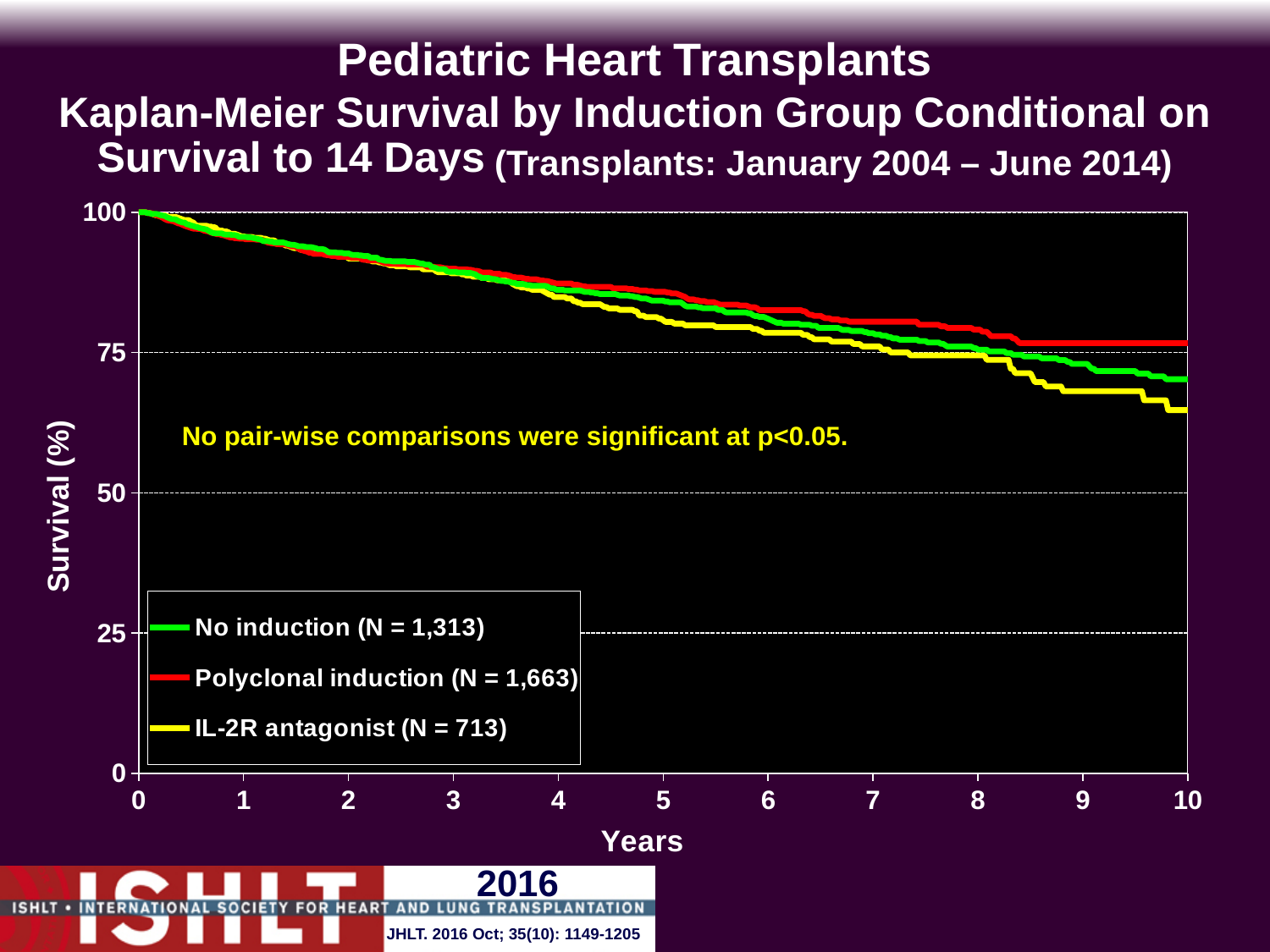
Is the survival for IL-2R antagonist at 10 years greater or less than 75? less What is the N for the Polyclonal induction group shown in the legend? 1,663 Which induction group has the highest survival at 10 years? Polyclonal induction How many series does the legend list? 3 Which induction group has the lowest survival at 10 years? IL-2R antagonist What kind of chart is shown on the slide? line chart What is the label of the y axis? Survival (%) At 10 years, which is larger: survival for No induction or for IL-2R antagonist? No induction Do the survival curves rise or fall as years increase? fall Is the survival for No induction at 5 years greater or less than 75? greater Is the survival for Polyclonal induction at 10 years greater or less than 75? greater What is the survival value for all groups at year 0? 100